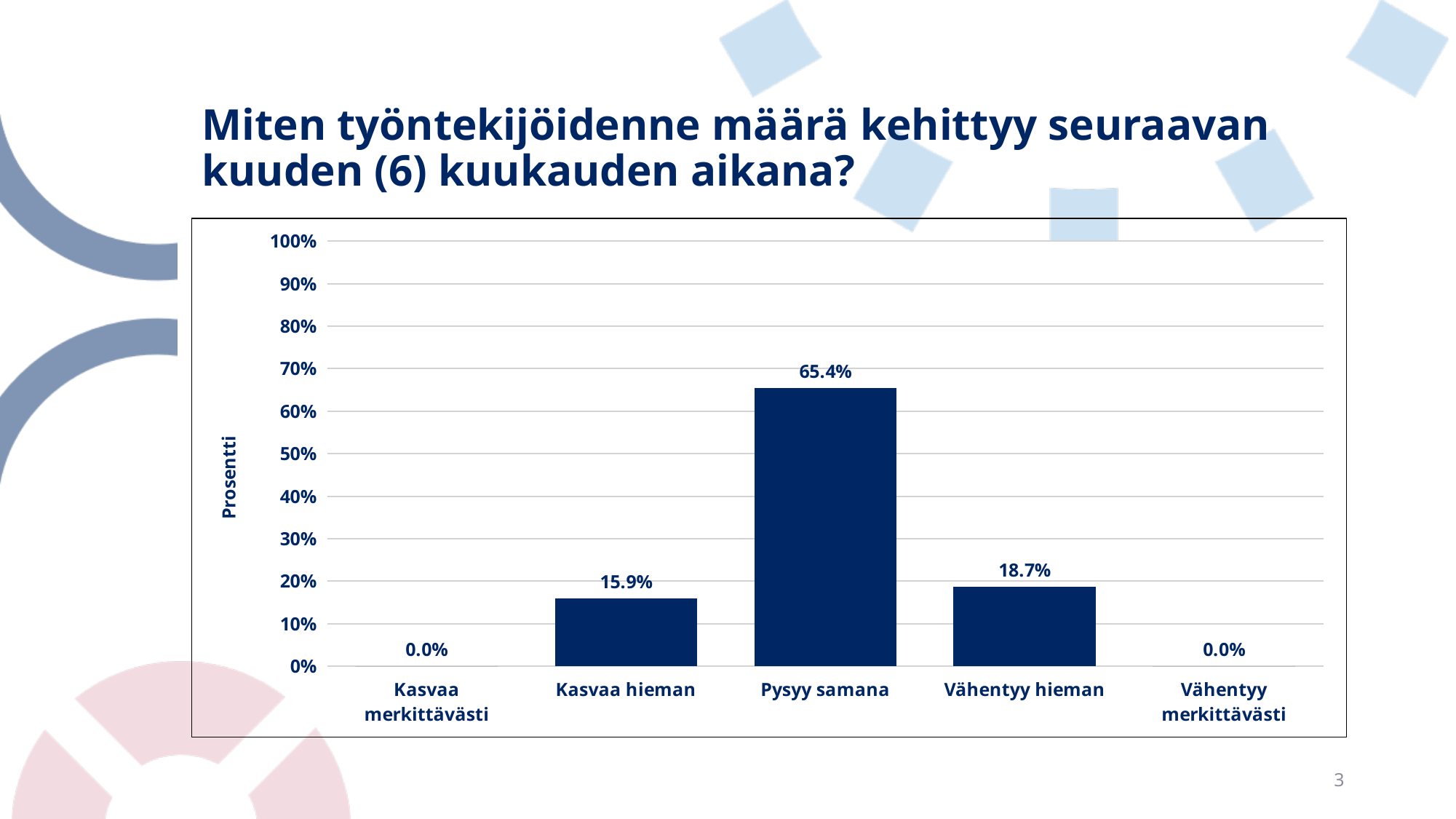
What kind of chart is shown on the slide? bar chart Is the value for Pysyy samana greater or less than 60%? greater What is the label of the vertical axis? Prosentti What is the value for Kasvaa merkittävästi? 0.0% What is the value for Kasvaa hieman? 15.9% Which category has the highest value? Pysyy samana What is the value for Pysyy samana? 65.4% What is the difference between Pysyy samana and Vähentyy hieman? 46.7% How many categories are shown on the x axis? 5 What is the value for Vähentyy hieman? 18.7% What is the difference between Vähentyy hieman and Kasvaa hieman? 2.8% Which is larger, Kasvaa hieman or Vähentyy hieman? Vähentyy hieman